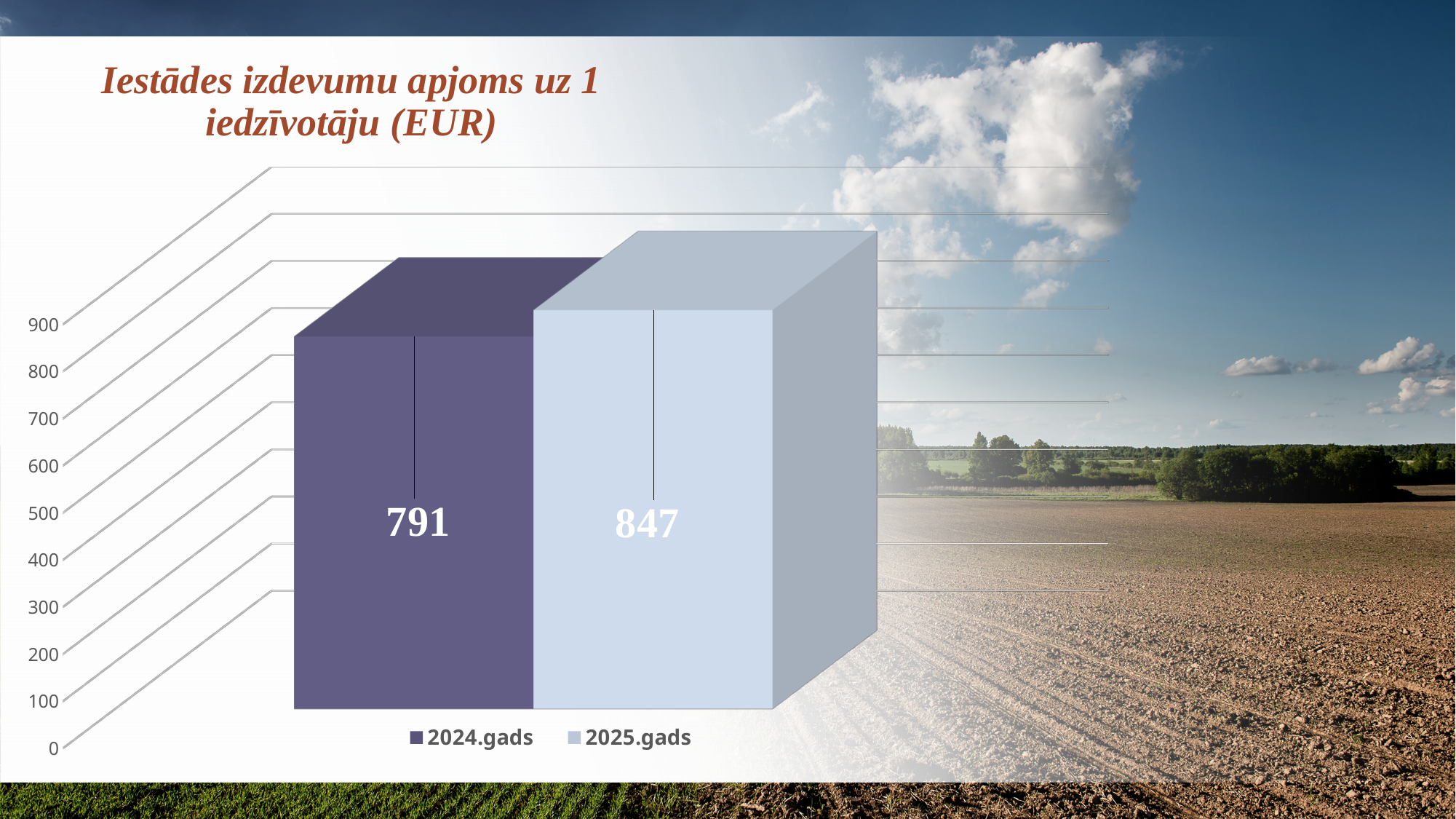
What is the highest value shown on the vertical axis? 900 Which series has the lowest value? 2024.gads Is the value for 2024.gads greater or less than 700? greater Which series has the higher value, 2024.gads or 2025.gads? 2025.gads What is the value for 2024.gads? 791 Is the value for 2025.gads greater or less than 900? less What is the value for 2025.gads? 847 What kind of chart is shown on the slide? bar chart What is the difference between the 2025.gads value and the 2024.gads value? 56 Which series has the highest value? 2025.gads What is the title of the chart? Iestādes izdevumu apjoms uz 1 iedzīvotāju (EUR) How many series does the legend list? 2